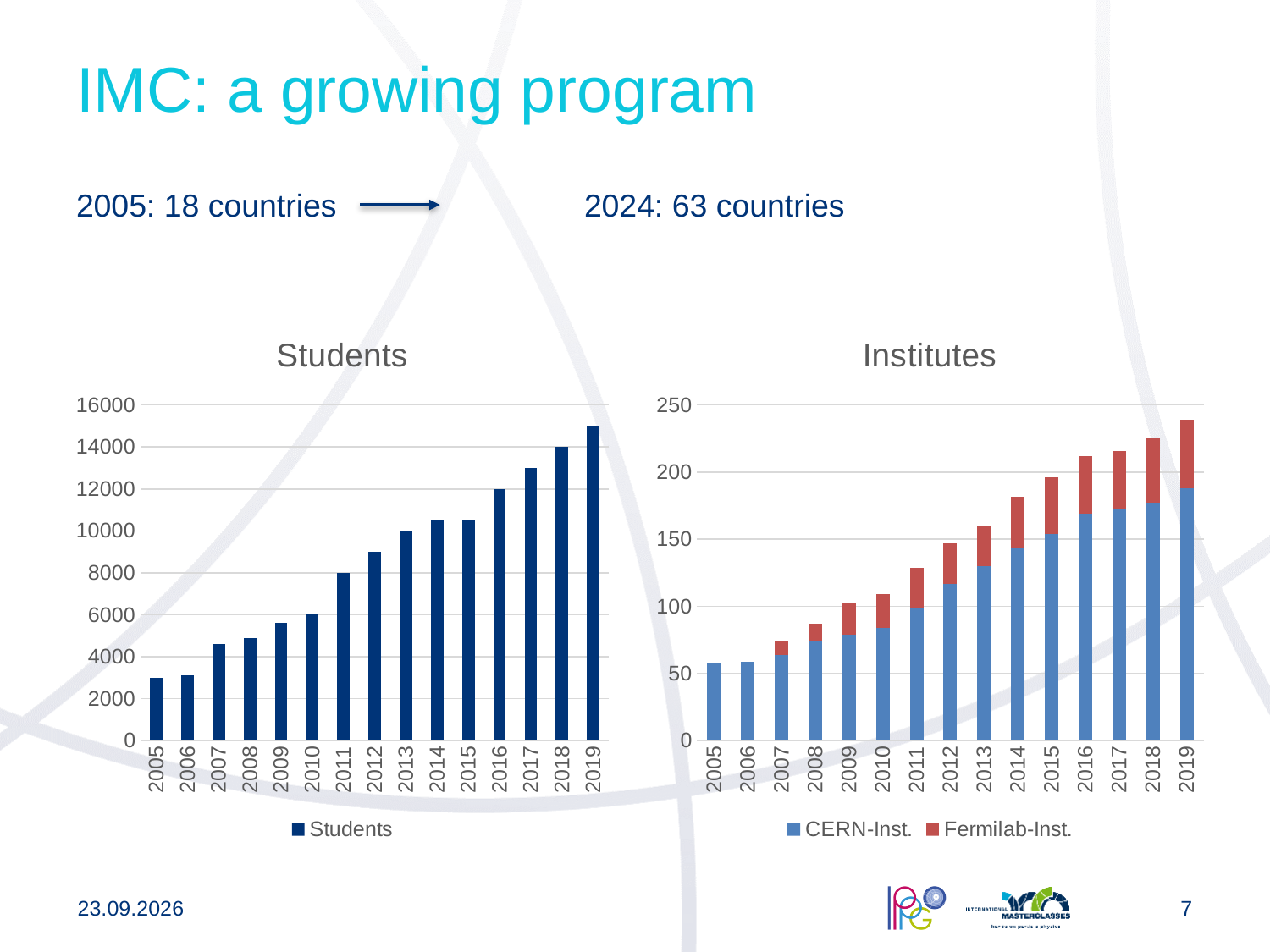
On the Students chart, how many years are plotted along the x axis? 15 On the Students chart, is the value for 2019 greater or less than 14000? greater On the Students chart, which year has the lowest number of students? 2005 On the Institutes chart, is the total for 2019 greater or less than 200? greater On the Students chart, do the values generally rise or fall from 2005 to 2019? Rise On the Institutes chart, which year has the tallest stacked bar? 2019 On the Institutes chart, what are the two series named in the legend? CERN-Inst. and Fermilab-Inst. On the Institutes chart, in 2019, which series is larger: CERN-Inst. or Fermilab-Inst.? CERN-Inst. On the Students chart, is the value for 2005 greater or less than 4000? less On the Institutes chart, how many series does the legend list? 2 On the Students chart, what kind of chart is shown? Bar chart On the Students chart, which year has the highest number of students? 2019